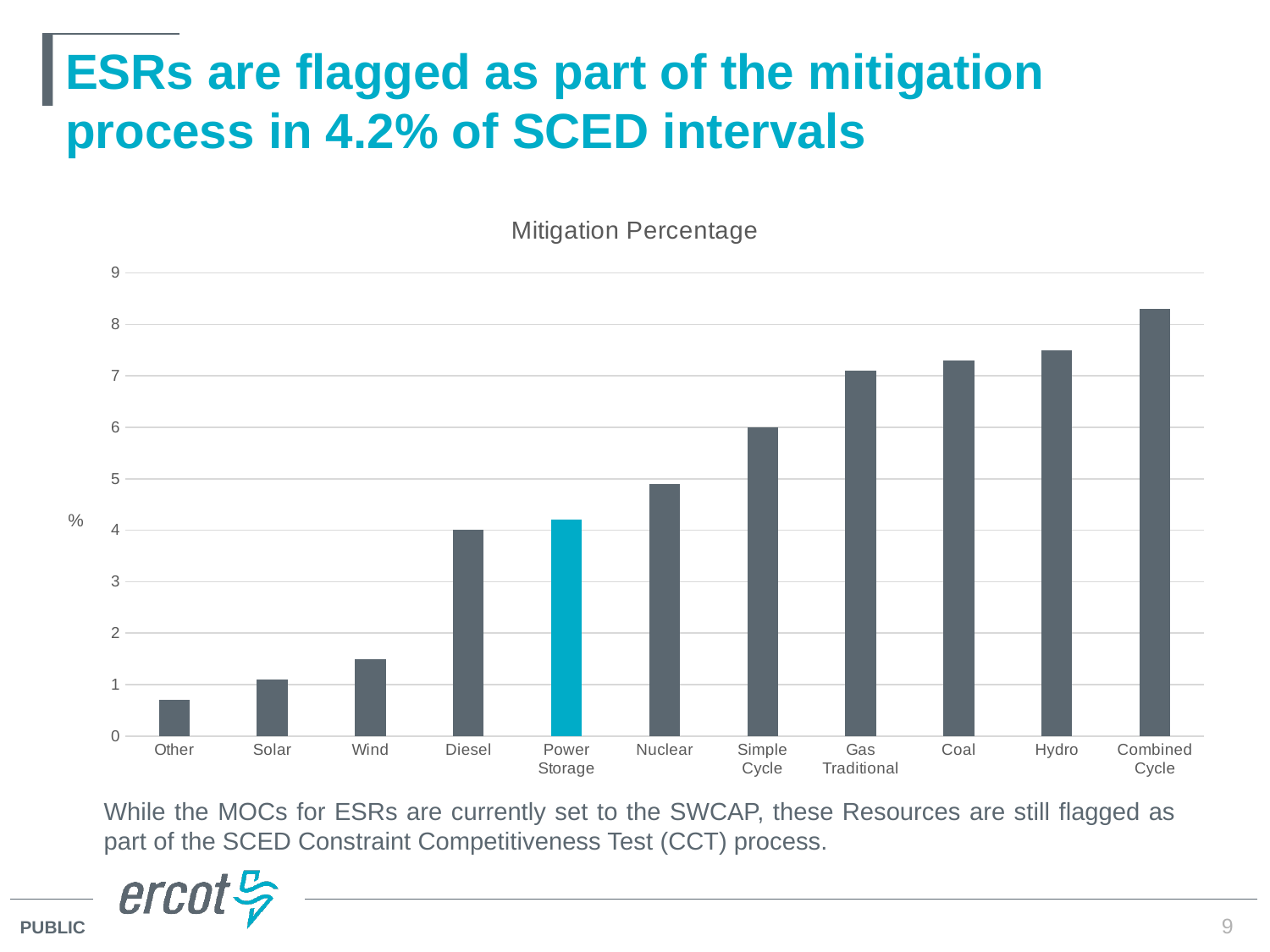
What is the mitigation percentage for Power Storage? 4.2% How many categories are plotted on the x axis of the chart? 11 Which is larger, the value for Nuclear or the value for Diesel? Nuclear What is the title of the chart? Mitigation Percentage Do the values rise or fall moving from left to right along the x axis? rise Which category has the lowest mitigation percentage? Other Is the value for Wind greater or less than 2? less Which category has the highest mitigation percentage? Combined Cycle Is the value for Hydro greater or less than 7? greater What is the mitigation percentage for Simple Cycle? 6 What is the mitigation percentage for Diesel? 4 What kind of chart is shown on the slide? bar chart